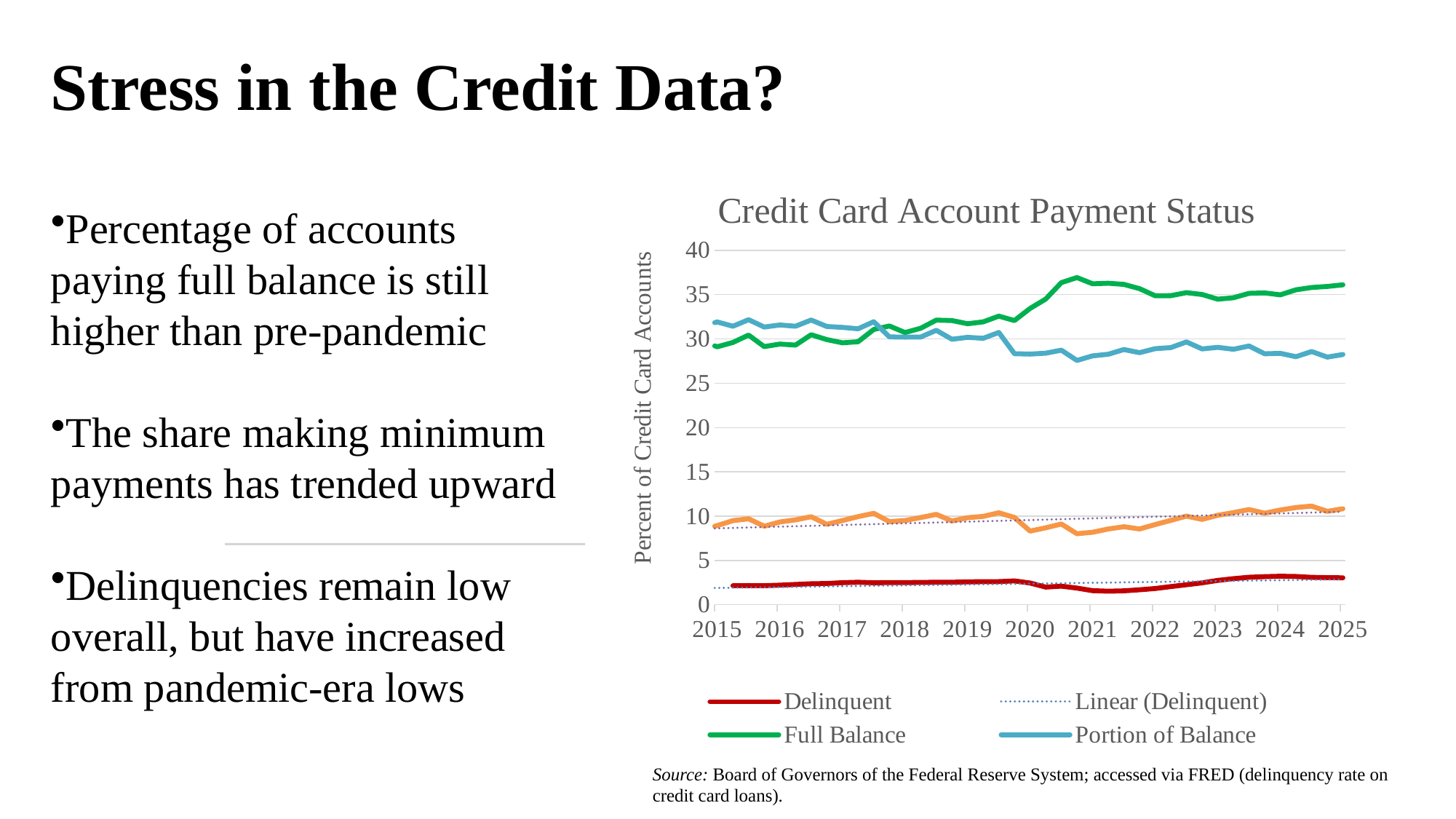
Is the value for Full Balance in 2025 greater or less than 35? greater Is the value for Portion of Balance in 2025 greater or less than 30? less How many series does the chart's legend list? 4 Is the value for Full Balance in 2021 greater or less than 30? greater In 2015, which is higher: Full Balance or Portion of Balance? Portion of Balance What is the label on the chart's vertical axis? Percent of Credit Card Accounts Does the Full Balance line rise or fall overall from 2015 to 2025? rise In 2025, which is higher: Full Balance or Portion of Balance? Full Balance Which series has the lowest values across the whole chart? Delinquent What is the title of the chart? Credit Card Account Payment Status What kind of chart is shown on the slide? line chart